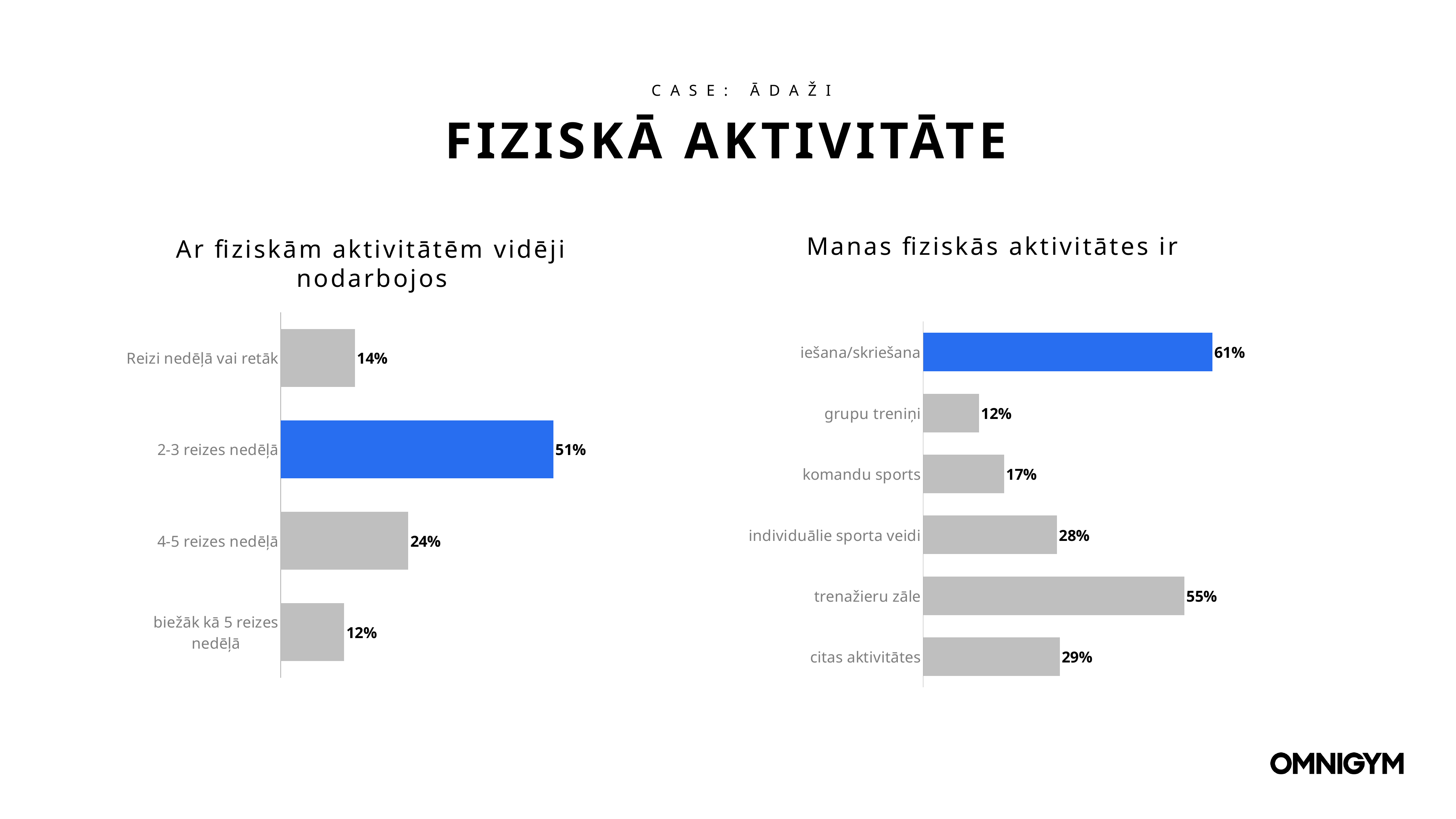
In the chart 'Ar fiziskām aktivitātēm vidēji nodarbojos', what is the difference between '4-5 reizes nedēļā' and 'Reizi nedēļā vai retāk'? 10% In the chart 'Ar fiziskām aktivitātēm vidēji nodarbojos', what is the value for '2-3 reizes nedēļā'? 51% In the chart 'Ar fiziskām aktivitātēm vidēji nodarbojos', how many categories are shown? 4 In the chart 'Ar fiziskām aktivitātēm vidēji nodarbojos', what is the value for 'biežāk kā 5 reizes nedēļā'? 12% In the chart 'Manas fiziskās aktivitātes ir', which category has the lowest value? grupu treniņi In the chart 'Manas fiziskās aktivitātes ir', what is the value for 'trenažieru zāle'? 55% In the chart 'Manas fiziskās aktivitātes ir', which is larger: 'individuālie sporta veidi' or 'citas aktivitātes'? citas aktivitātes In the chart 'Manas fiziskās aktivitātes ir', what is the value for 'komandu sports'? 17% In the chart 'Ar fiziskām aktivitātēm vidēji nodarbojos', which category has the highest value? 2-3 reizes nedēļā What type of chart is 'Manas fiziskās aktivitātes ir'? Bar chart In the chart 'Manas fiziskās aktivitātes ir', what is the difference between 'iešana/skriešana' and 'trenažieru zāle'? 6% In the chart 'Manas fiziskās aktivitātes ir', which category has the highest value? iešana/skriešana